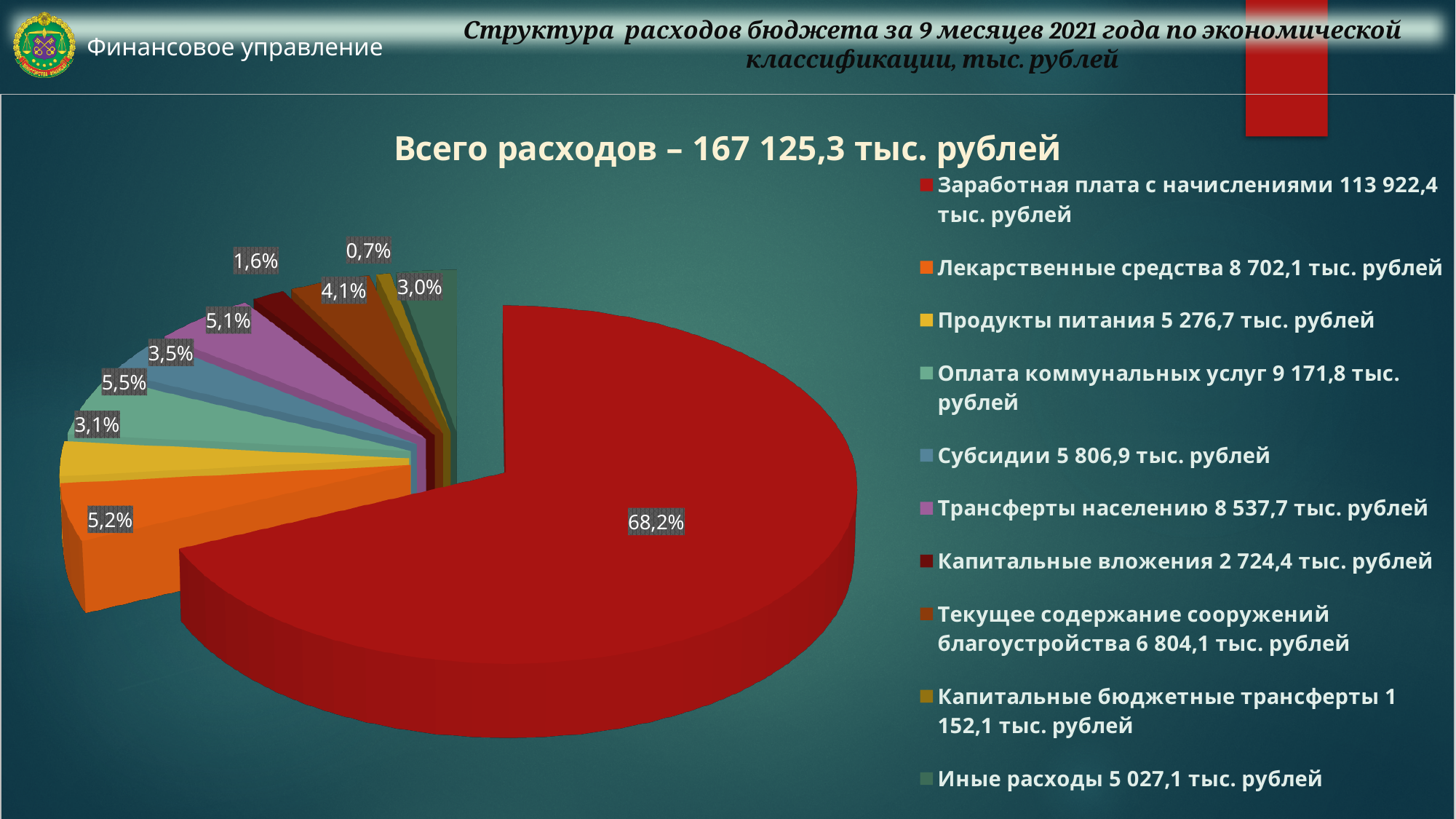
What share of the pie does "Заработная плата с начислениями" take? 68,2% Which category has the largest slice of the pie? Заработная плата с начислениями According to the legend, what is the amount for "Трансферты населению"? 8 537,7 тыс. рублей What share of the pie does "Капитальные бюджетные трансферты" take? 0,7% How many categories does the legend of the pie chart list? 10 What share of the pie does "Оплата коммунальных услуг" take? 5,5% What type of chart is shown on the slide? pie chart Which is larger: the share for "Текущее содержание сооружений благоустройства" or the share for "Капитальные вложения"? Текущее содержание сооружений благоустройства According to the legend, what is the amount for "Субсидии"? 5 806,9 тыс. рублей Which category has the smallest slice of the pie? Капитальные бюджетные трансферты What total expenditure is stated in the chart title? 167 125,3 тыс. рублей